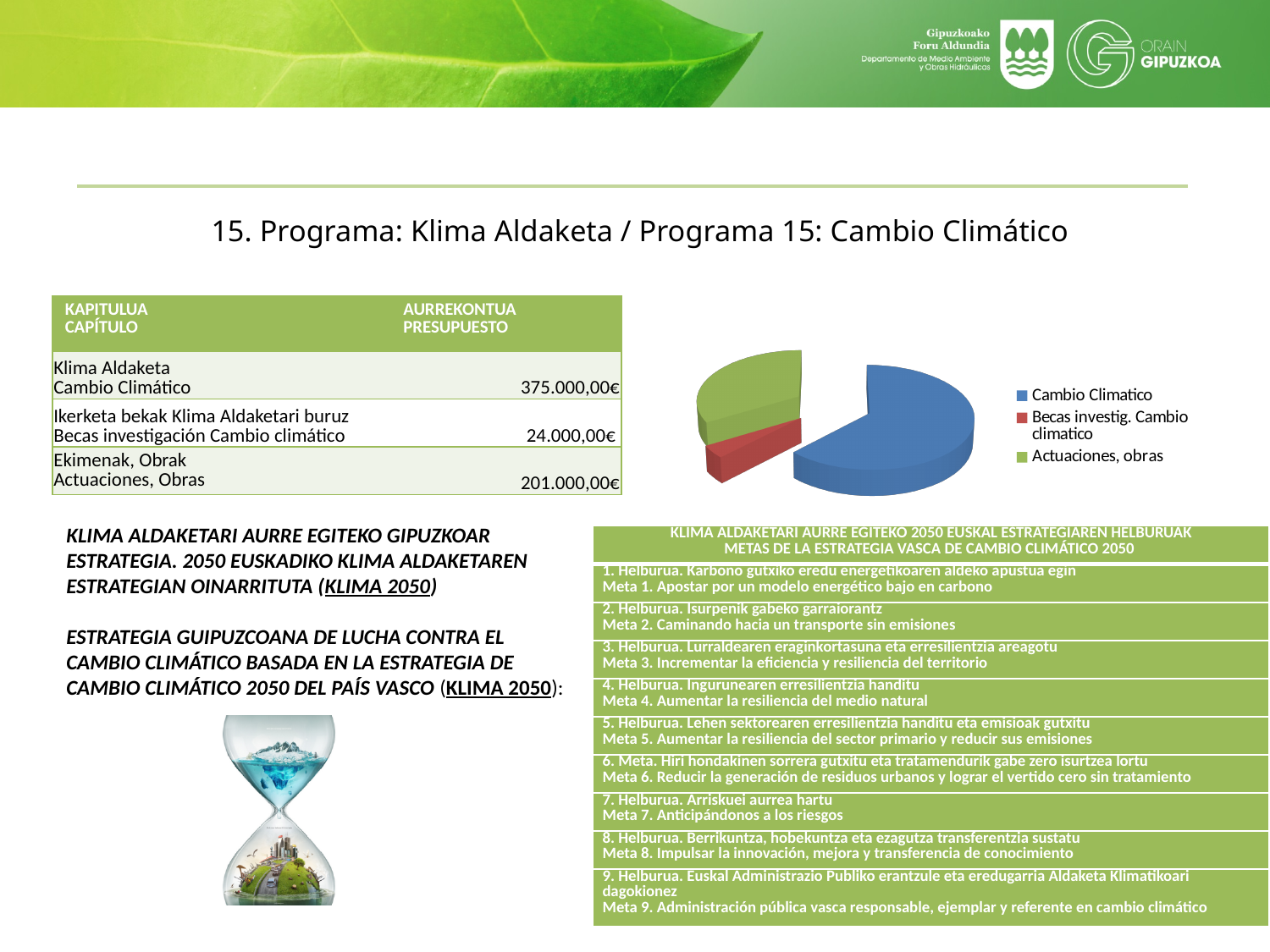
In the pie chart, which slice is larger: Becas investig. Cambio climatico or Actuaciones, obras? Actuaciones, obras How many entries does the legend of the pie chart list? 3 In the pie chart, which slice is larger: Cambio Climatico or Actuaciones, obras? Cambio Climatico Which category has the smallest slice in the pie chart? Becas investig. Cambio climatico Which category has the largest slice in the pie chart? Cambio Climatico How many slices does the pie chart have? 3 What kind of chart is shown on the slide? pie chart Which legend entry of the pie chart is shown in green? Actuaciones, obras What colour is the Cambio Climatico slice in the pie chart? blue